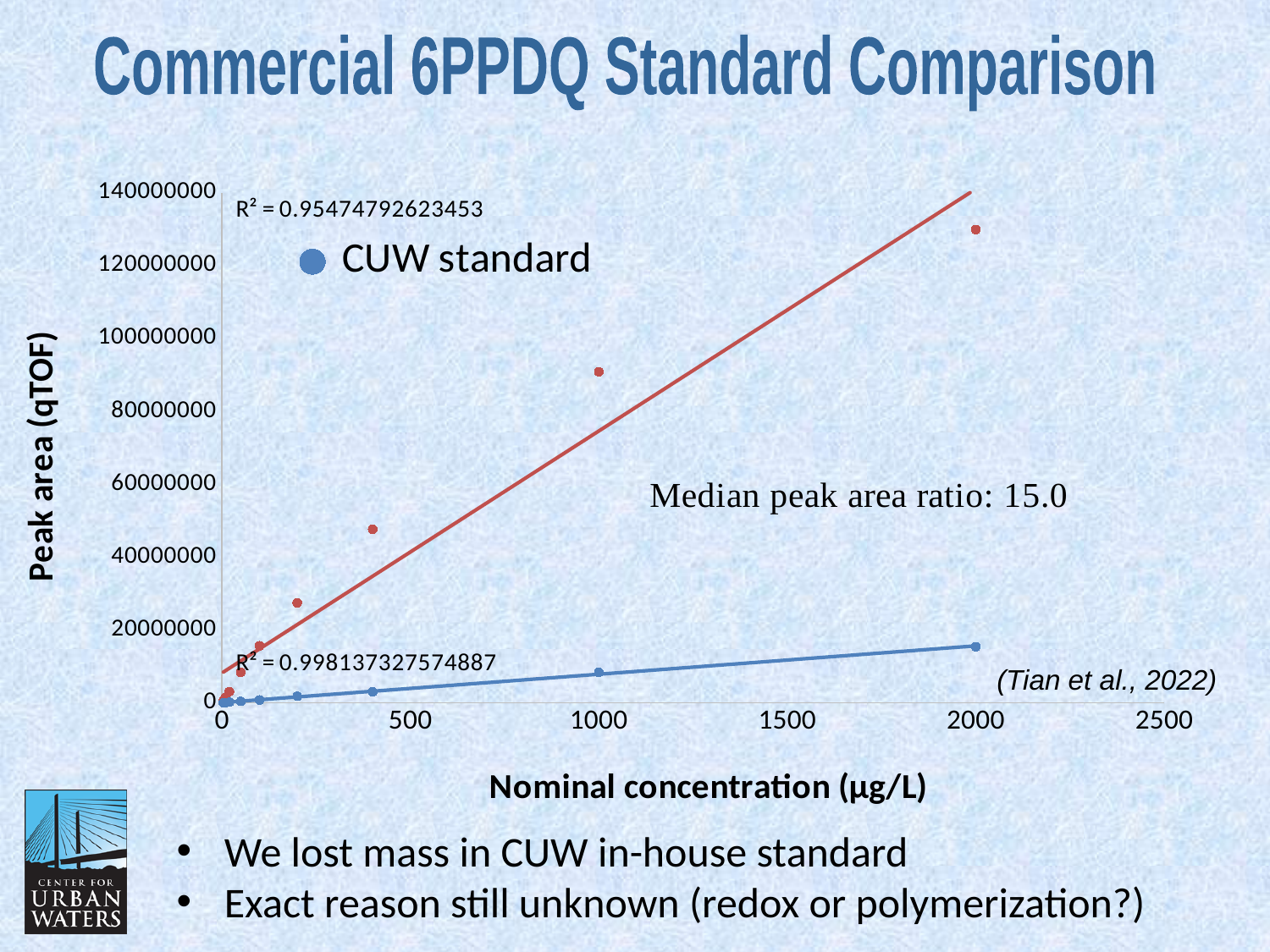
Is the red series' peak area at a nominal concentration of 1000 µg/L greater or less than 80000000? greater Is the CUW standard's peak area at a nominal concentration of 2000 µg/L greater or less than 20000000? less What is the highest tick value shown on the y axis? 140000000 Is the red series' peak area at a nominal concentration of 2000 µg/L greater or less than 120000000? greater What R² value is printed near the bottom of the chart for the blue series? R² = 0.998137327574887 Do the peak area values rise or fall as nominal concentration increases along the x axis? Rise What is the title of the chart's y axis? Peak area (qTOF) At a nominal concentration of 2000 µg/L, which series has the larger peak area, the red series or the CUW standard? The red series What median peak area ratio is stated on the chart? 15.0 What is the title of the chart's x axis? Nominal concentration (µg/L) What kind of chart is shown on the slide? Scatter chart What R² value is printed near the top of the chart for the red series? R² = 0.95474792623453